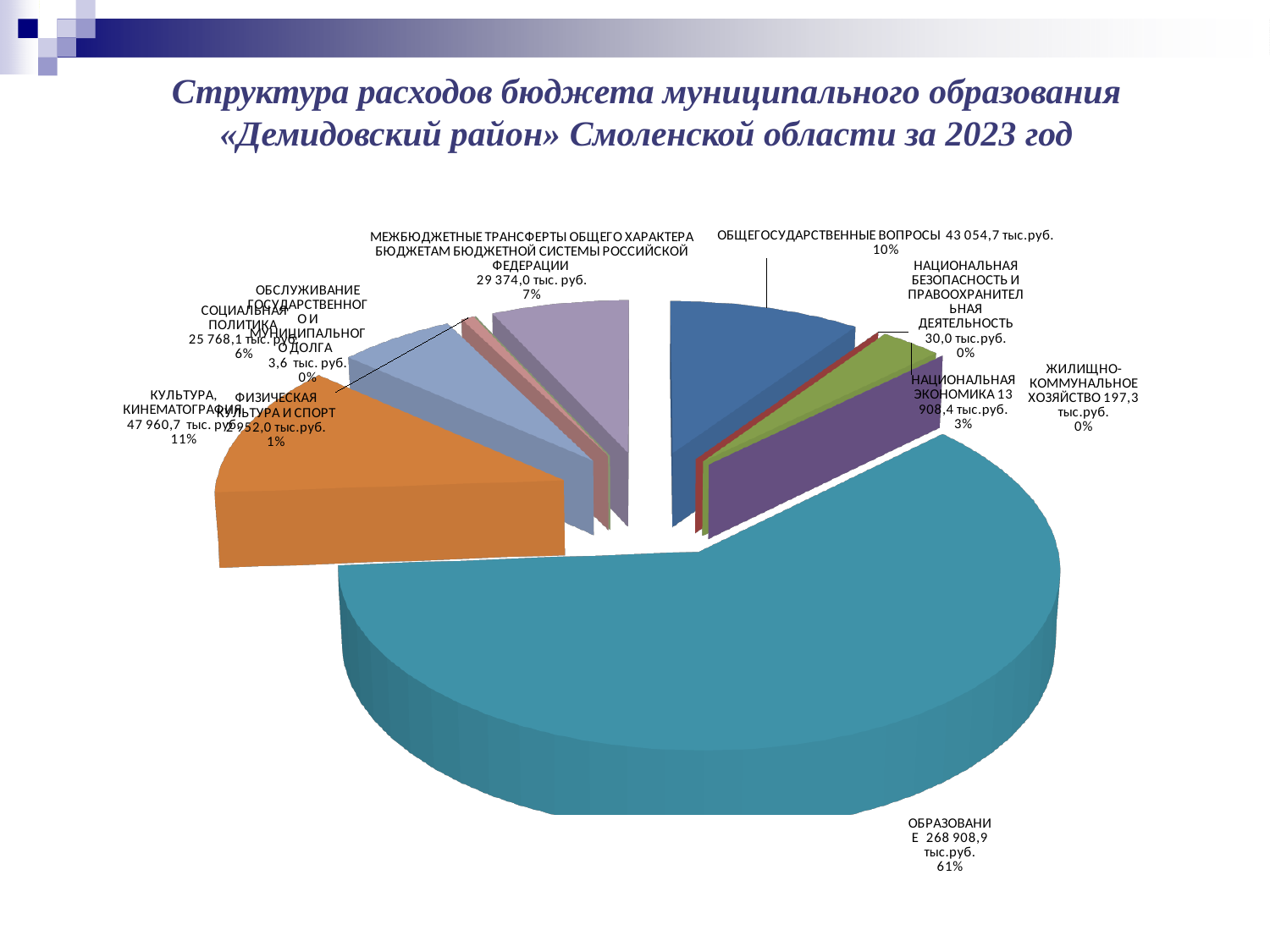
What type of chart is shown on the slide? pie chart What is the value for ОБРАЗОВАНИЕ? 268 908,9 тыс.руб. Which is larger: КУЛЬТУРА, КИНЕМАТОГРАФИЯ or СОЦИАЛЬНАЯ ПОЛИТИКА? КУЛЬТУРА, КИНЕМАТОГРАФИЯ What share of the pie does ОБРАЗОВАНИЕ represent? 61% What year does the chart title refer to? 2023 What is the difference between ОБЩЕГОСУДАРСТВЕННЫЕ ВОПРОСЫ and МЕЖБЮДЖЕТНЫЕ ТРАНСФЕРТЫ ОБЩЕГО ХАРАКТЕРА БЮДЖЕТАМ БЮДЖЕТНОЙ СИСТЕМЫ РОССИЙСКОЙ ФЕДЕРАЦИИ? 13 680,7 тыс. руб. What is the value for КУЛЬТУРА, КИНЕМАТОГРАФИЯ? 47 960,7 тыс. руб. What share of the pie does НАЦИОНАЛЬНАЯ ЭКОНОМИКА represent? 3% Which category has the largest share of the pie? ОБРАЗОВАНИЕ Which category has the smallest value? ОБСЛУЖИВАНИЕ ГОСУДАРСТВЕННОГО И МУНИЦИПАЛЬНОГО ДОЛГА What is the value for ОБЩЕГОСУДАРСТВЕННЫЕ ВОПРОСЫ? 43 054,7 тыс.руб. How many categories are shown in the pie chart? 10